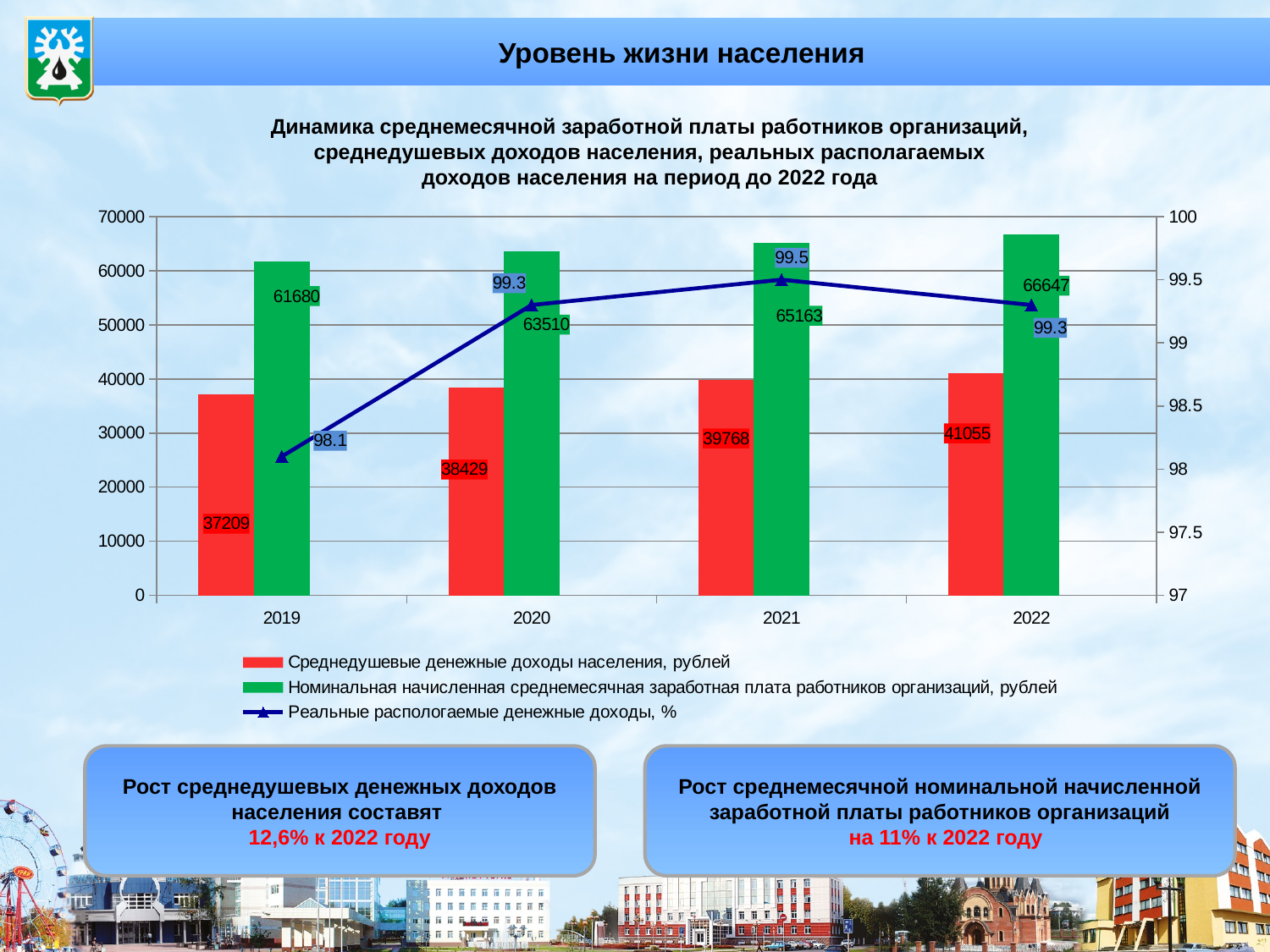
Do the values of Среднедушевые денежные доходы населения rise or fall from 2019 to 2022? rise How many series does the legend list? 3 In which year is Номинальная начисленная среднемесячная заработная плата работников организаций the highest? 2022 Is the value of Среднедушевые денежные доходы населения for 2022 greater or less than 40000? greater How many years are shown on the x axis? 4 What is the difference between Среднедушевые денежные доходы населения in 2022 and in 2019? 3846 Which is larger in 2020: Среднедушевые денежные доходы населения or Номинальная начисленная среднемесячная заработная плата? Номинальная начисленная среднемесячная заработная плата In which year is Реальные распологаемые денежные доходы, % the lowest? 2019 What is the difference between Номинальная начисленная среднемесячная заработная плата and Среднедушевые денежные доходы in 2021? 25395 What is the value of Номинальная начисленная среднемесячная заработная плата работников организаций for 2022? 66647 What is the value of Реальные распологаемые денежные доходы, % for 2021? 99.5 What is the value of Среднедушевые денежные доходы населения for 2019? 37209